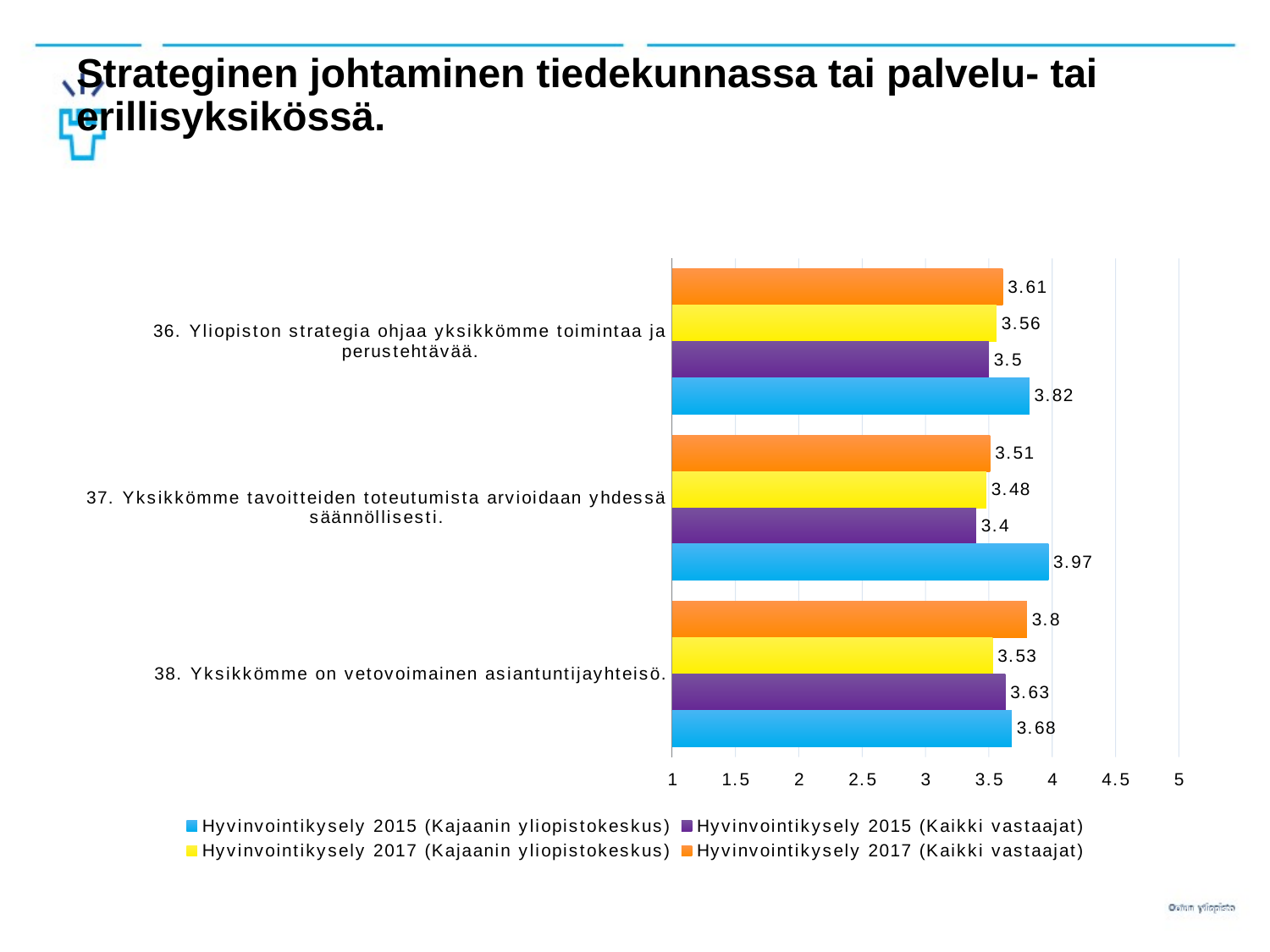
Which statement has the lowest value for Hyvinvointikysely 2015 (Kaikki vastaajat)? 37. Yksikkömme tavoitteiden toteutumista arvioidaan yhdessä säännöllisesti. For statement 38, which is larger: Hyvinvointikysely 2017 (Kaikki vastaajat) or Hyvinvointikysely 2017 (Kajaanin yliopistokeskus)? Hyvinvointikysely 2017 (Kaikki vastaajat) How many series does the legend list? 4 What is the value for Hyvinvointikysely 2017 (Kajaanin yliopistokeskus) for statement 37? 3.48 What is the value for Hyvinvointikysely 2015 (Kaikki vastaajat) for statement 36? 3.5 How many categories (statements) are shown on the chart? 3 What is the value for Hyvinvointikysely 2017 (Kaikki vastaajat) for statement 38? 3.8 What is the value for Hyvinvointikysely 2015 (Kajaanin yliopistokeskus) for statement 37? 3.97 What is the difference between the Hyvinvointikysely 2015 (Kajaanin yliopistokeskus) and Hyvinvointikysely 2017 (Kajaanin yliopistokeskus) values for statement 36? 0.26 Which statement has the highest value for Hyvinvointikysely 2015 (Kajaanin yliopistokeskus)? 37. Yksikkömme tavoitteiden toteutumista arvioidaan yhdessä säännöllisesti. What kind of chart is shown on the slide? Bar chart Which colour represents Hyvinvointikysely 2017 (Kajaanin yliopistokeskus) in the chart? Yellow